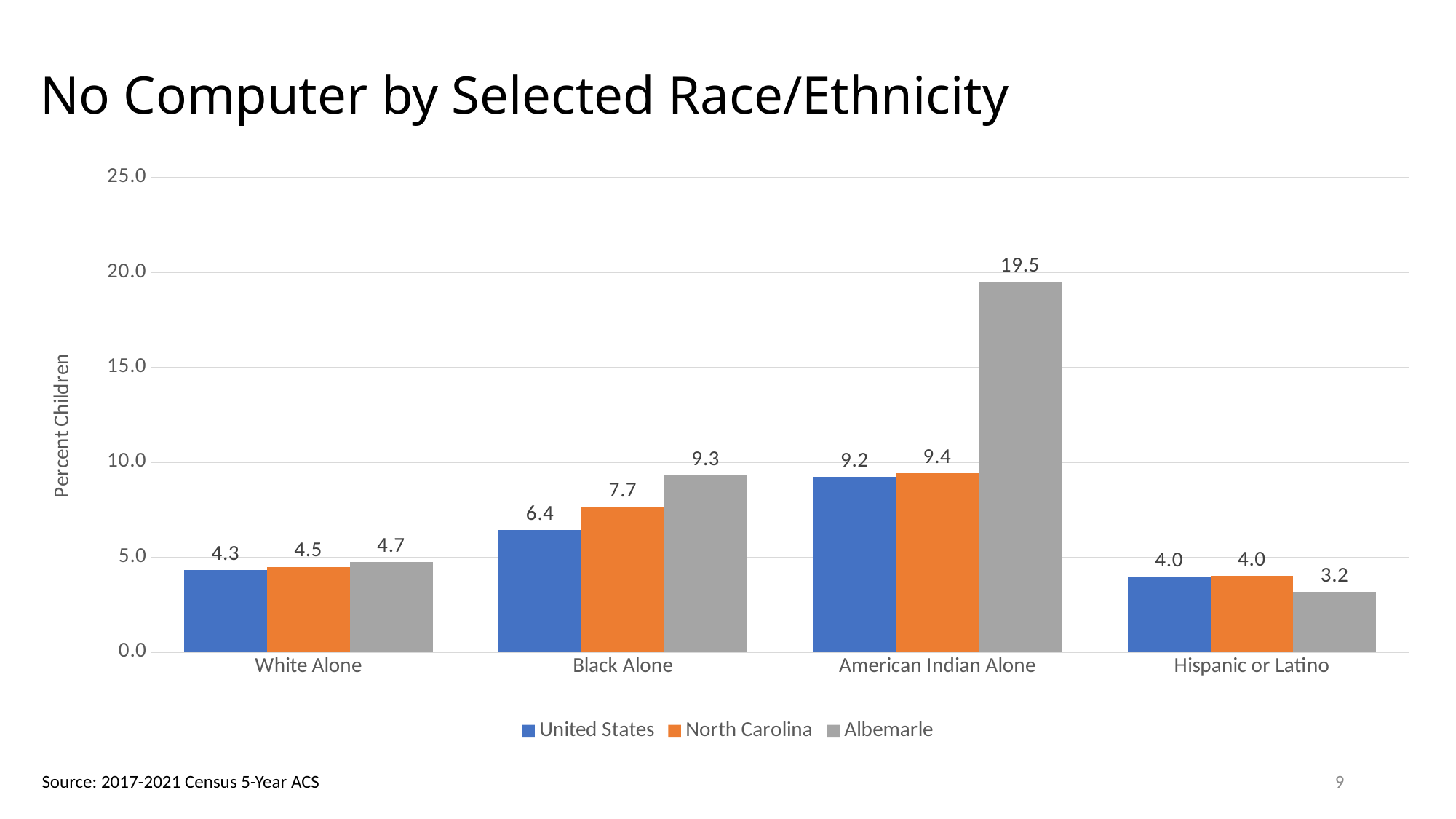
For Hispanic or Latino, which is larger: the United States value or the Albemarle value? United States Which category has the highest Albemarle value? American Indian Alone What is the North Carolina value for White Alone? 4.5 What is the difference between the Albemarle and North Carolina values for American Indian Alone? 10.1 Which category has the lowest Albemarle value? Hispanic or Latino What is the difference between the North Carolina and United States values for Black Alone? 1.3 What kind of chart is shown on the slide? Bar chart What is the Albemarle value for American Indian Alone? 19.5 What is the label on the vertical axis? Percent Children How many race/ethnicity categories are shown on the x axis? 4 What is the United States value for Black Alone? 6.4 How many series does the legend list? 3